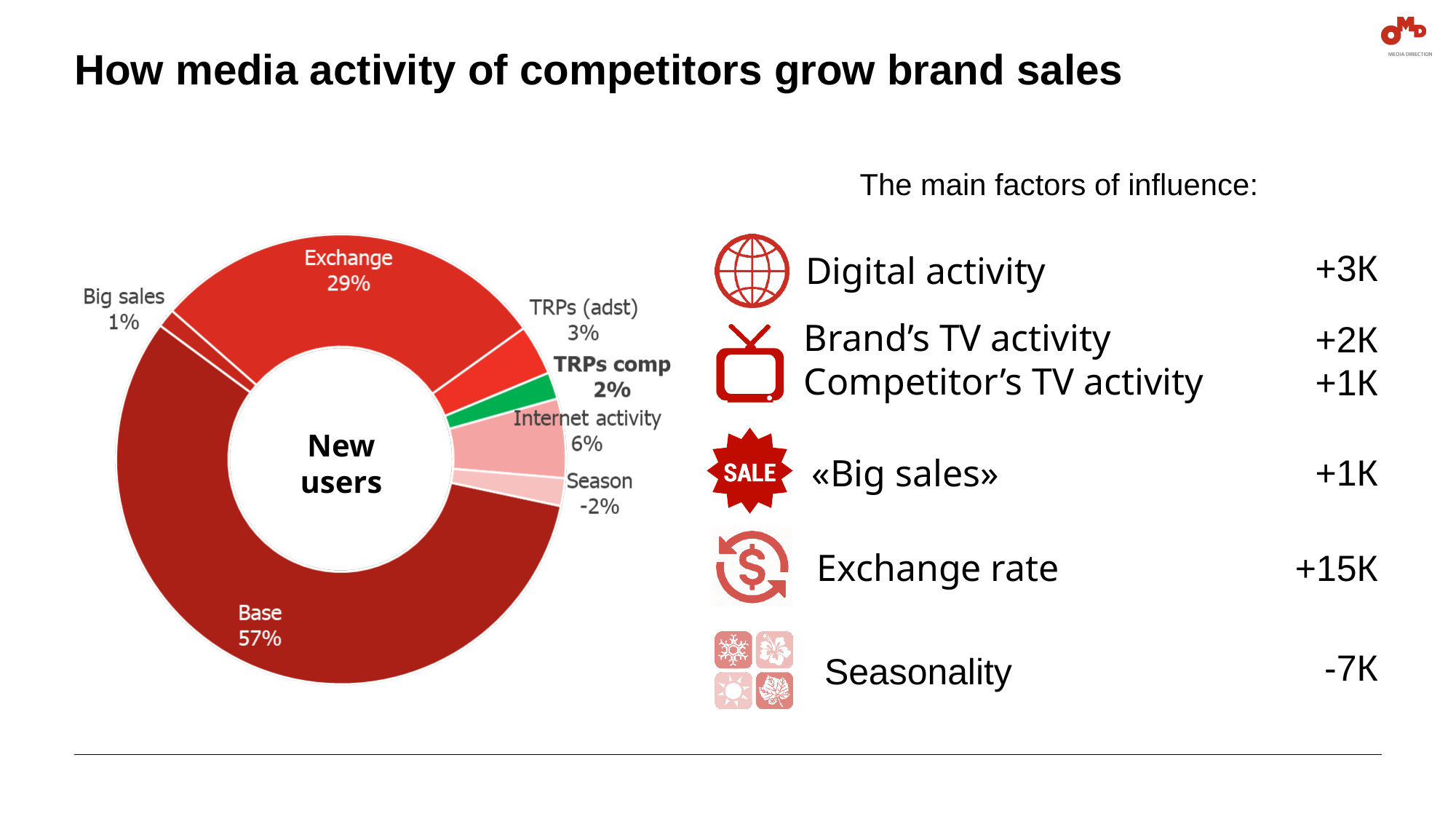
What text is written in the centre of the donut chart? New users What percentage does the Exchange slice represent in the pie chart? 29% What value is shown for Season in the pie chart? -2% What value is shown for TRPs comp in the pie chart? 2% Which slice of the pie chart has the largest share? Base What value is shown for Internet activity in the pie chart? 6% How many categories are labelled in the pie chart? 7 Which is larger in the pie chart, TRPs (adst) or Big sales? TRPs (adst) What kind of chart is shown on the slide? Pie chart What percentage does the Base slice represent in the pie chart? 57% Which category in the pie chart has the lowest value? Season What is the difference between the Exchange share and the Internet activity share in the pie chart? 23%